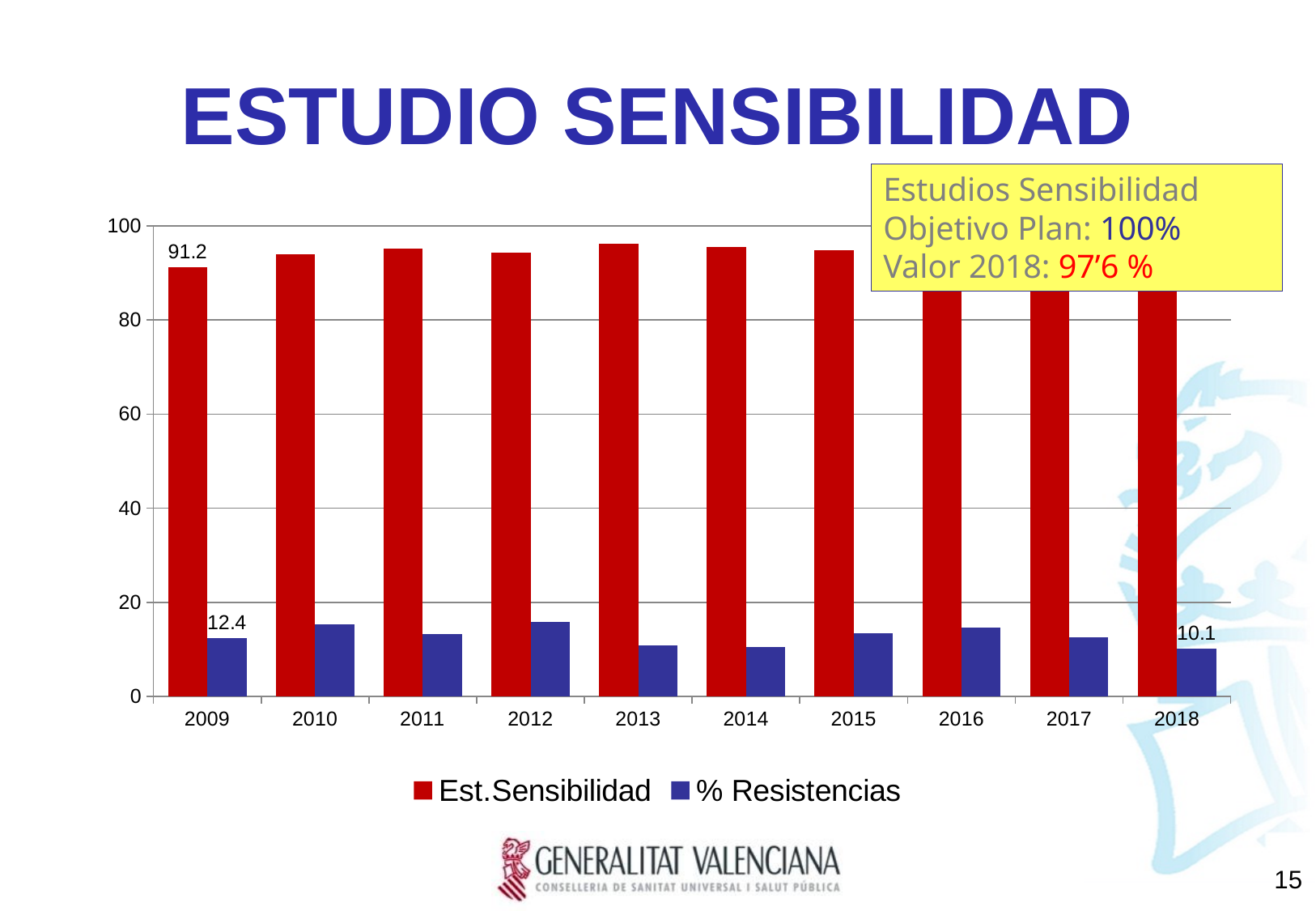
What is the value of % Resistencias for 2018? 10.1 What kind of chart is shown on the slide? Bar chart What is the value of Est.Sensibilidad for 2009? 91.2 What is the value of % Resistencias for 2009? 12.4 Is the value for % Resistencias in 2012 greater or less than 20? less Is the value for Est.Sensibilidad in 2013 greater or less than 80? greater How many years are shown on the x axis? 10 What is the difference between the % Resistencias values for 2009 and 2018? 2.3 Which year has the larger % Resistencias value, 2009 or 2018? 2009 What colour are the Est.Sensibilidad bars? Red According to the text box on the slide, what is the Objetivo Plan for Estudios Sensibilidad? 100% How many series does the legend list? 2